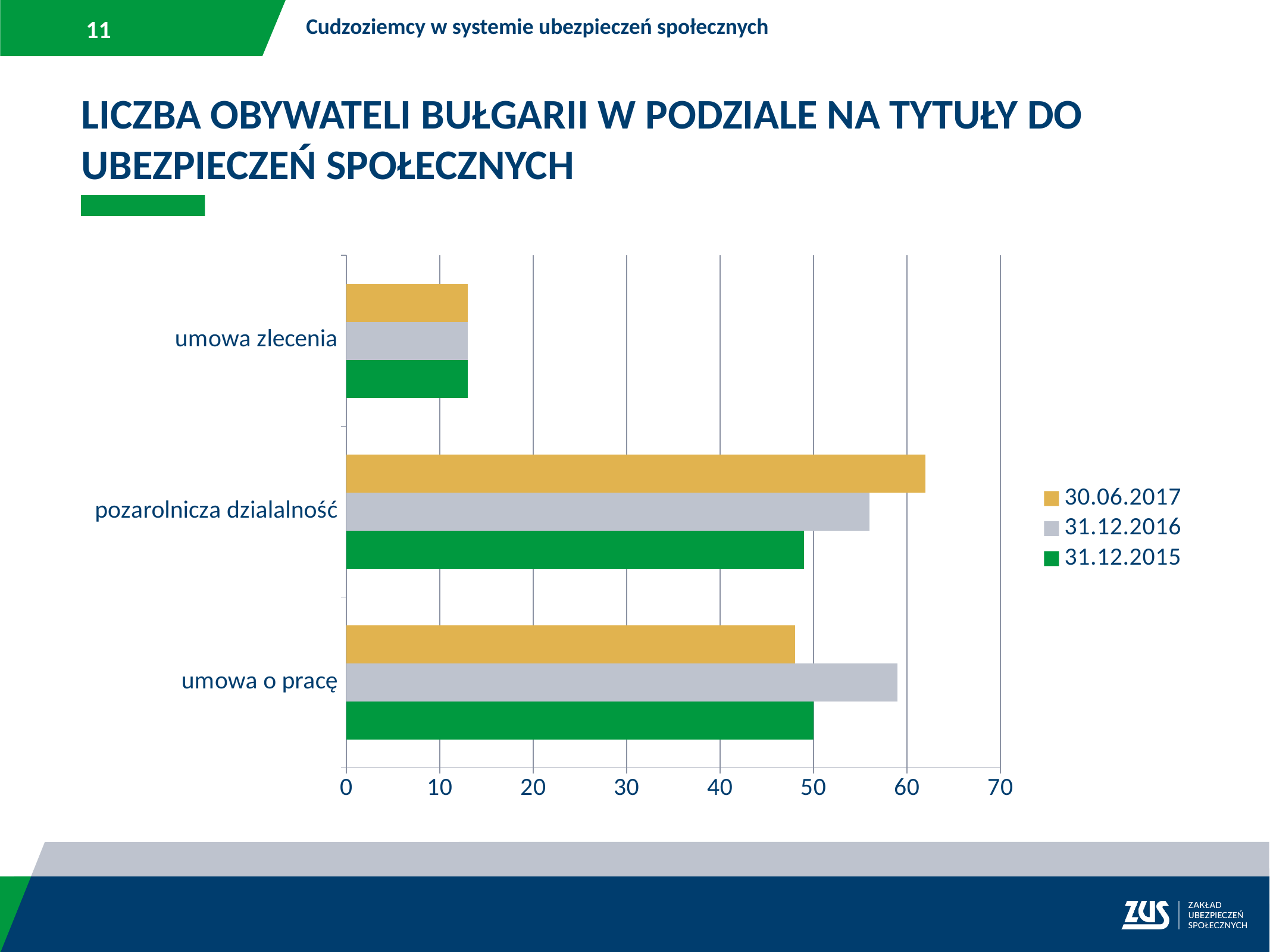
How many series does the legend list? 3 Which category has the lowest value for the 31.12.2015 series? umowa zlecenia How many categories are shown on the chart? 3 Which colour represents the 31.12.2015 series in the legend? green Which category has the highest value for the 30.06.2017 series? pozarolnicza dzialalność Is the value for pozarolnicza dzialalność in the 30.06.2017 series greater or less than 60? greater Which category has the lowest value for the 30.06.2017 series? umowa zlecenia For pozarolnicza dzialalność, which series has the larger value: 30.06.2017 or 31.12.2016? 30.06.2017 What kind of chart is shown on the slide? bar chart For umowa o pracę, which series has the larger value: 31.12.2016 or 30.06.2017? 31.12.2016 Is the value for umowa o pracę in the 31.12.2016 series greater or less than 50? greater Is the value for umowa zlecenia in the 31.12.2016 series greater or less than 20? less